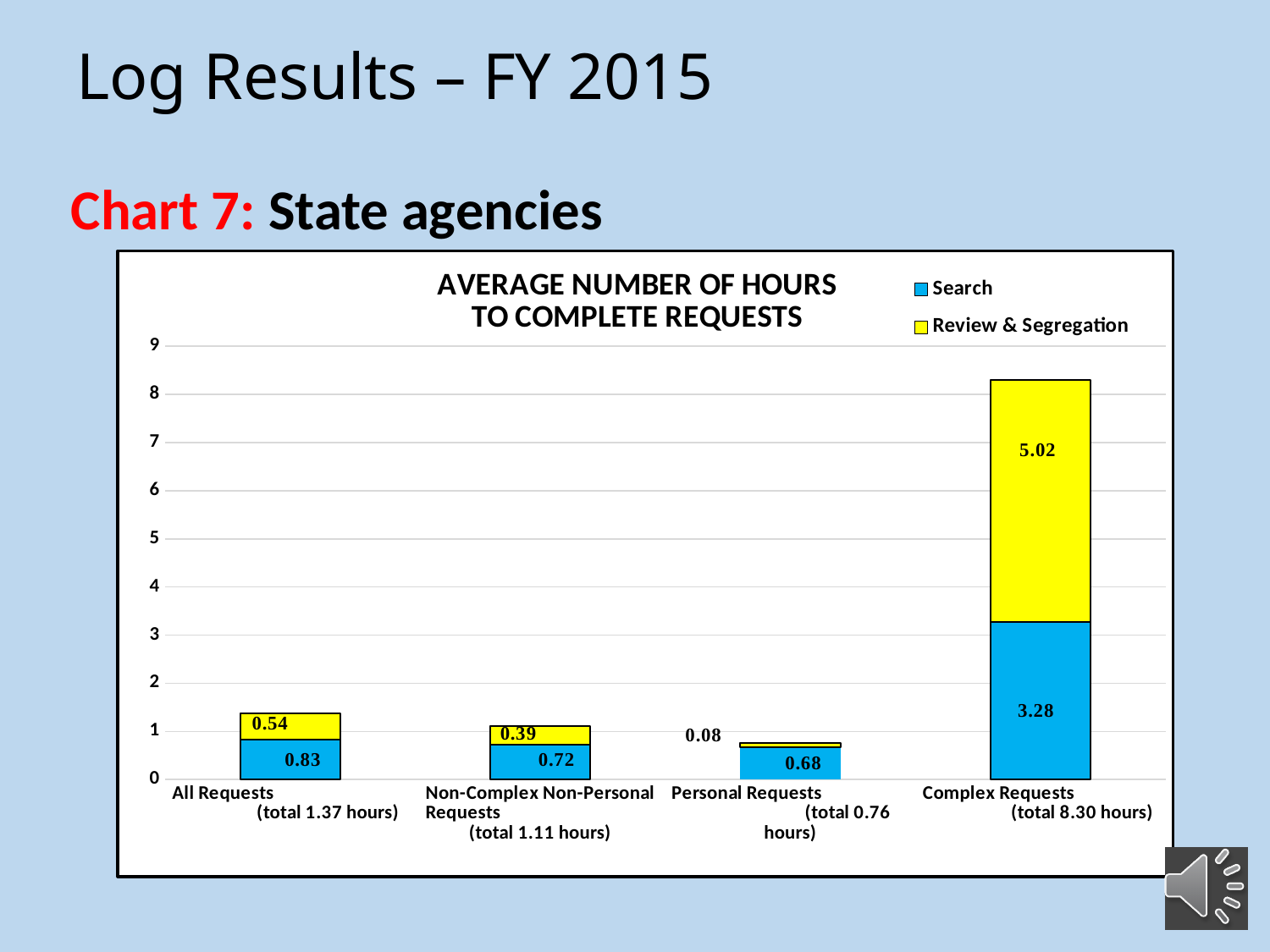
What is the Review & Segregation value for Non-Complex Non-Personal Requests? 0.39 What is the difference between the Review & Segregation value and the Search value for Complex Requests? 1.74 Which category has the lowest Review & Segregation value? Personal Requests How many series does the legend list? 2 What is the Review & Segregation value for All Requests? 0.54 Which is larger: the Search value for All Requests or the Search value for Non-Complex Non-Personal Requests? All Requests What is the Search value for Personal Requests? 0.68 How many categories are shown on the x axis? 4 What is the Search value for Complex Requests? 3.28 What is the total of the stacked bar for Complex Requests? 8.30 Which category has the highest Review & Segregation value? Complex Requests What kind of chart is shown? Stacked bar chart